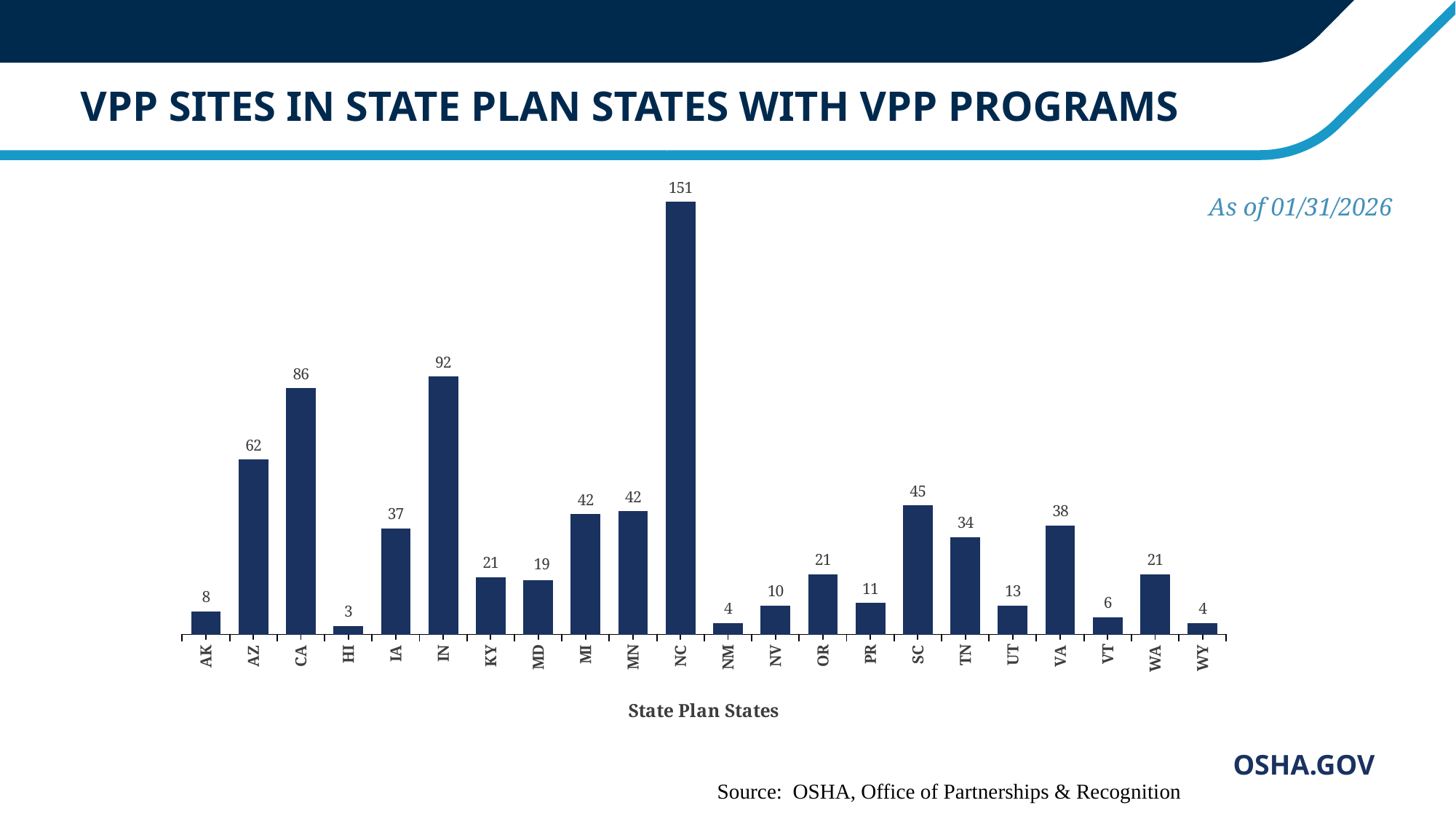
What kind of chart is shown on the slide? Bar chart Which state has the lowest number of VPP sites? HI Which has a larger value, IA or MI? MI How many states are shown on the x axis? 22 How many VPP sites does the chart show for NC? 151 Which has a larger value, SC or TN? SC What is the difference between the values for NC and IN? 59 What is the value shown for VA? 38 What is the x-axis title of the chart? State Plan States Which state has the highest number of VPP sites? NC What is the value shown for IN? 92 What is the difference between the values for CA and AZ? 24